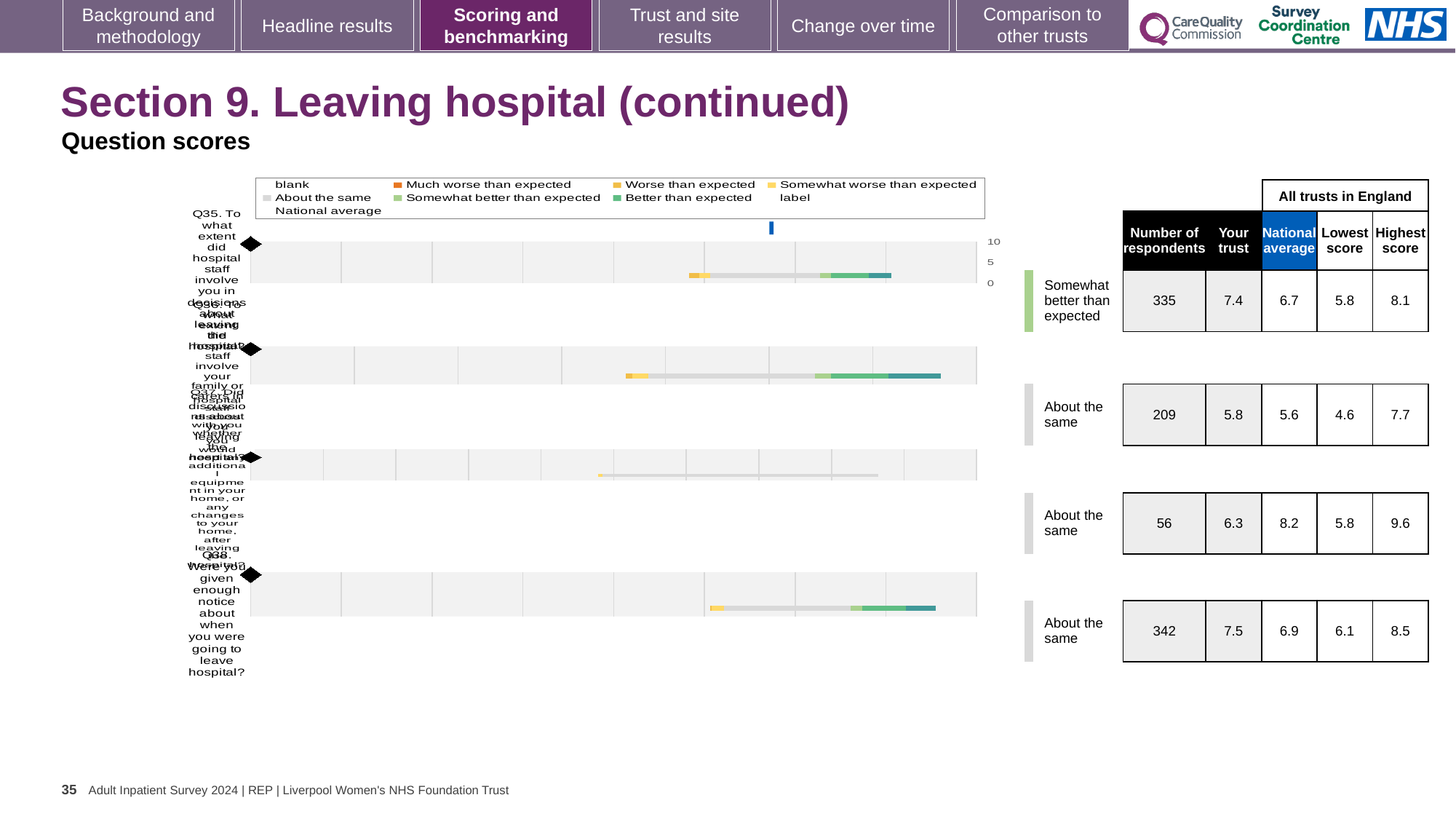
What benchmark category is shown for Q35? Somewhat better than expected What is the 'Your trust' score for Q35 (involving you in decisions about leaving hospital)? 7.4 What kind of chart is used to show the question scores on this slide? bar chart Which question row has the lowest number of respondents? Q37 For Q37, which is larger: the 'Your trust' score or the national average? National average How many respondents answered Q37 (the third question row)? 56 What is the highest score among all trusts in England for Q37? 9.6 For Q38, what is the difference between the highest score and the lowest score among all trusts in England? 2.4 How many question rows (Q35 to Q38) are plotted in the chart? 4 For Q35, how much higher is the 'Your trust' score than the national average? 0.7 Which question row has the highest 'Your trust' score? Q38 What is the national average score for Q38 (given enough notice about leaving hospital)? 6.9